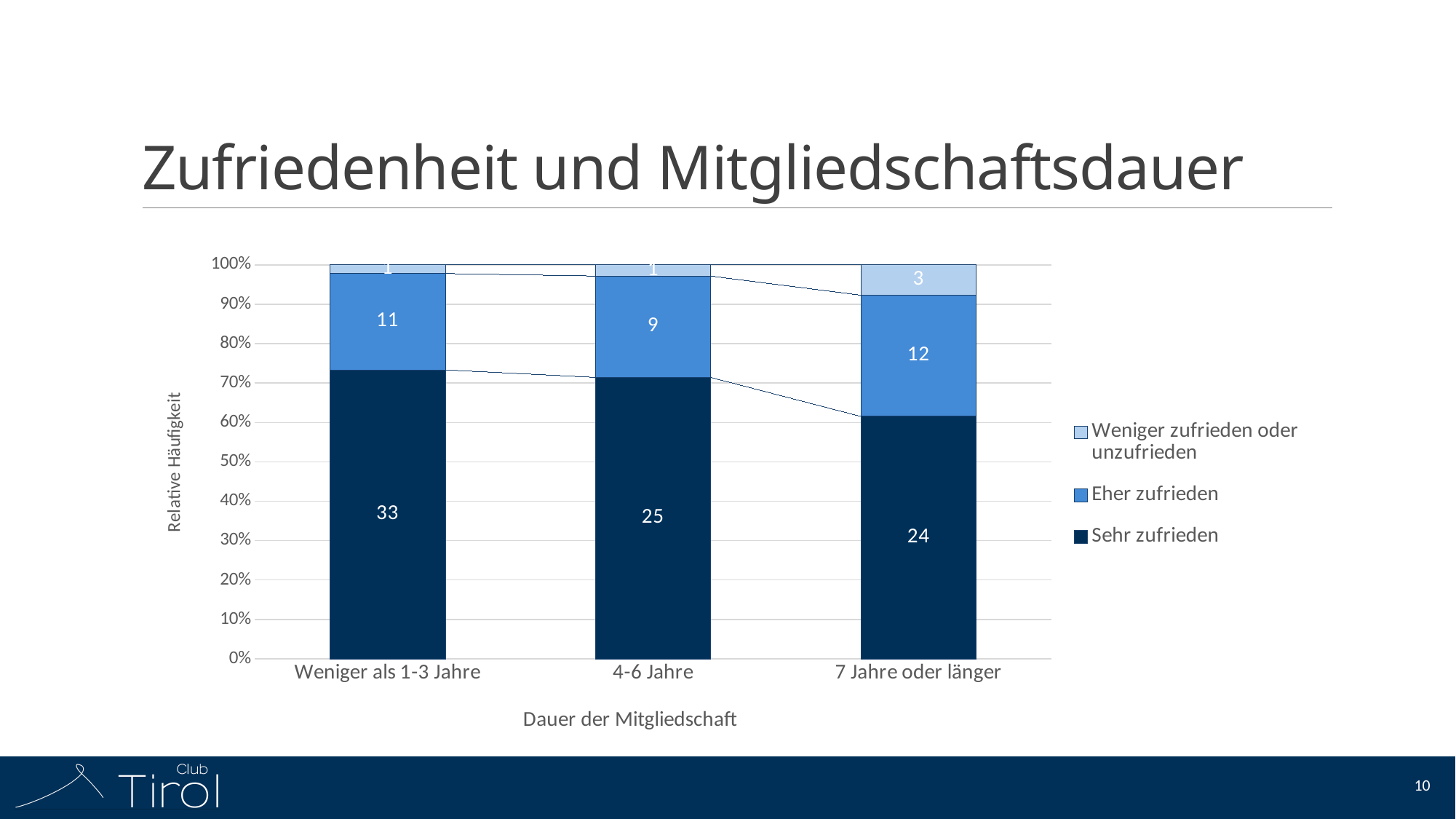
Which is larger: the 'Eher zufrieden' value for 'Weniger als 1-3 Jahre' or for '7 Jahre oder länger'? 7 Jahre oder länger What type of chart is shown on the slide? Stacked bar chart Which category has the highest value for 'Sehr zufrieden'? Weniger als 1-3 Jahre What is the value for 'Sehr zufrieden' in the '4-6 Jahre' category? 25 What is the value for 'Weniger zufrieden oder unzufrieden' in the 'Weniger als 1-3 Jahre' category? 1 How many membership-duration categories are shown on the x axis? 3 Is the share of 'Sehr zufrieden' in the '7 Jahre oder länger' bar greater or less than 70%? less What is the value for 'Eher zufrieden' in the '7 Jahre oder länger' category? 12 How many series does the legend list? 3 What is the difference between the 'Sehr zufrieden' values for 'Weniger als 1-3 Jahre' and '7 Jahre oder länger'? 9 What is the total of the three values in the 'Weniger als 1-3 Jahre' bar? 45 Which category has the lowest value for 'Eher zufrieden'? 4-6 Jahre